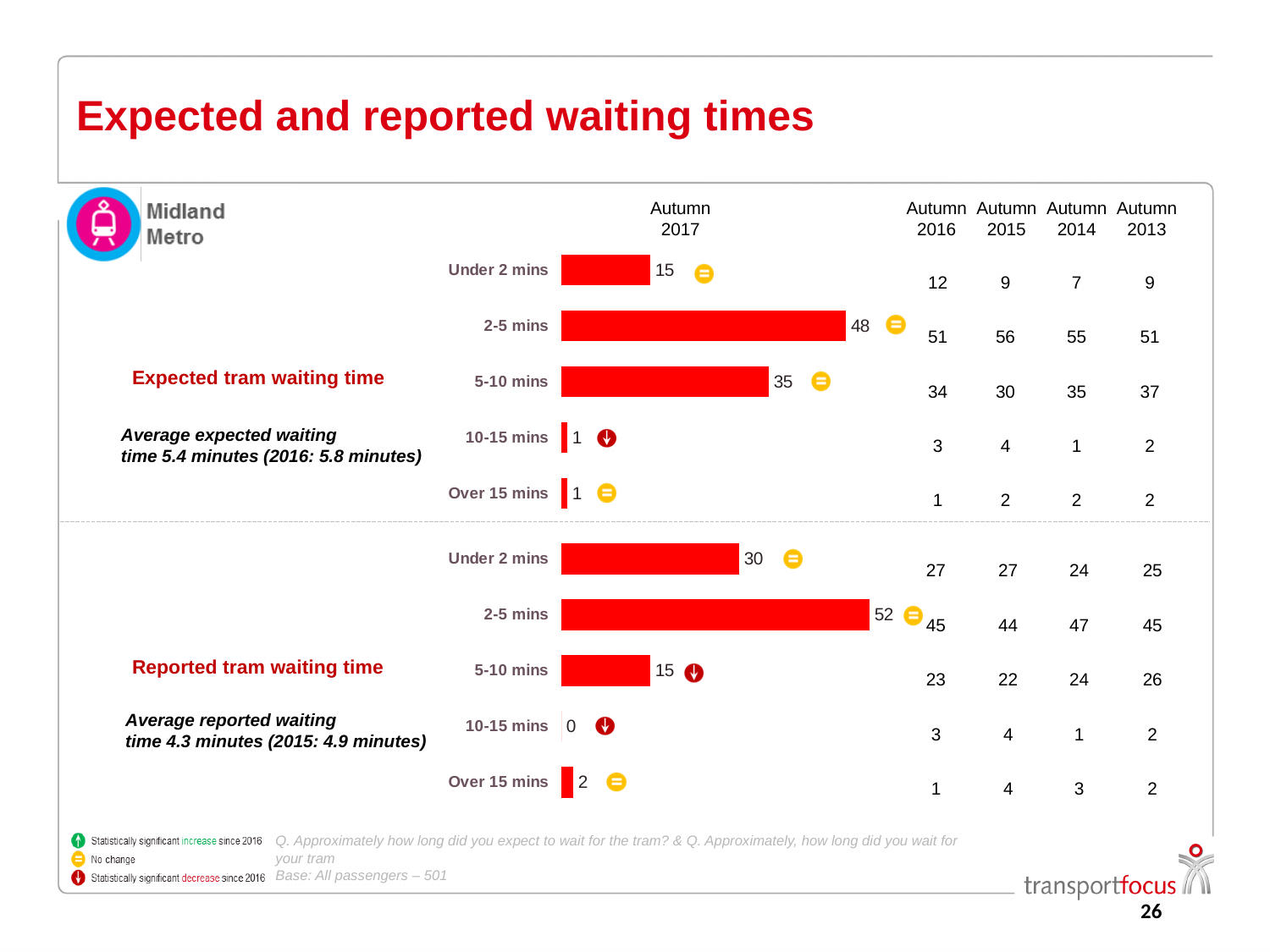
In the Reported tram waiting time chart, what is the difference between the Autumn 2017 values for Under 2 mins and 5-10 mins? 15 What is the title of the slide? Expected and reported waiting times In the Reported tram waiting time chart, what is the Autumn 2017 value for Under 2 mins? 30 In the Expected tram waiting time chart, which is larger for Autumn 2017: Under 2 mins or 5-10 mins? 5-10 mins In the Reported tram waiting time chart, which is larger for Autumn 2017: Under 2 mins or 5-10 mins? Under 2 mins How many categories are shown in the Expected tram waiting time chart? 5 In the Expected tram waiting time chart, what is the Autumn 2017 value for 2-5 mins? 48 What kind of chart is used for the Reported tram waiting time? Bar chart In the Expected tram waiting time chart, what is the difference between the Autumn 2017 values for 2-5 mins and 5-10 mins? 13 In the Expected tram waiting time chart, which category has the highest Autumn 2017 value? 2-5 mins In the Reported tram waiting time chart, what is the Autumn 2017 value for 5-10 mins? 15 In the Reported tram waiting time chart, which category has the lowest Autumn 2017 value? 10-15 mins